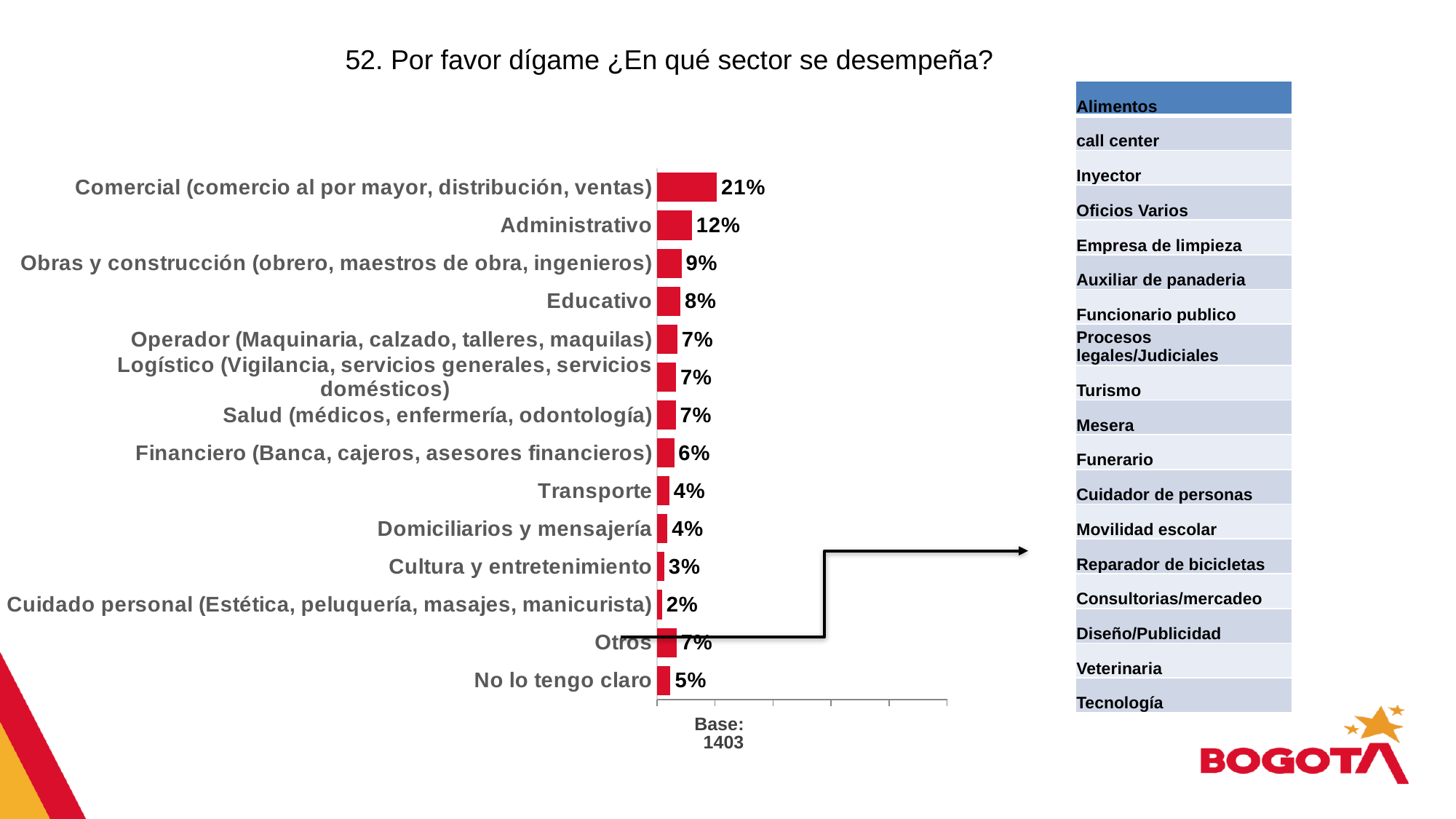
What percentage is shown for Administrativo? 12% What colour are the bars in the chart? Red What kind of chart is shown on the slide? Bar chart What percentage is shown for Educativo? 8% How many sector categories are plotted in the bar chart? 14 What percentage is shown for Comercial (comercio al por mayor, distribución, ventas)? 21% Which sector has the lowest percentage? Cuidado personal (Estética, peluquería, masajes, manicurista) What percentage is shown for No lo tengo claro? 5% Which is larger, the value for Transporte or the value for Financiero (Banca, cajeros, asesores financieros)? Financiero (Banca, cajeros, asesores financieros) What is the base (number of respondents) shown below the chart? 1403 Which sector has the highest percentage? Comercial (comercio al por mayor, distribución, ventas) What is the difference in percentage points between Comercial and Administrativo? 9